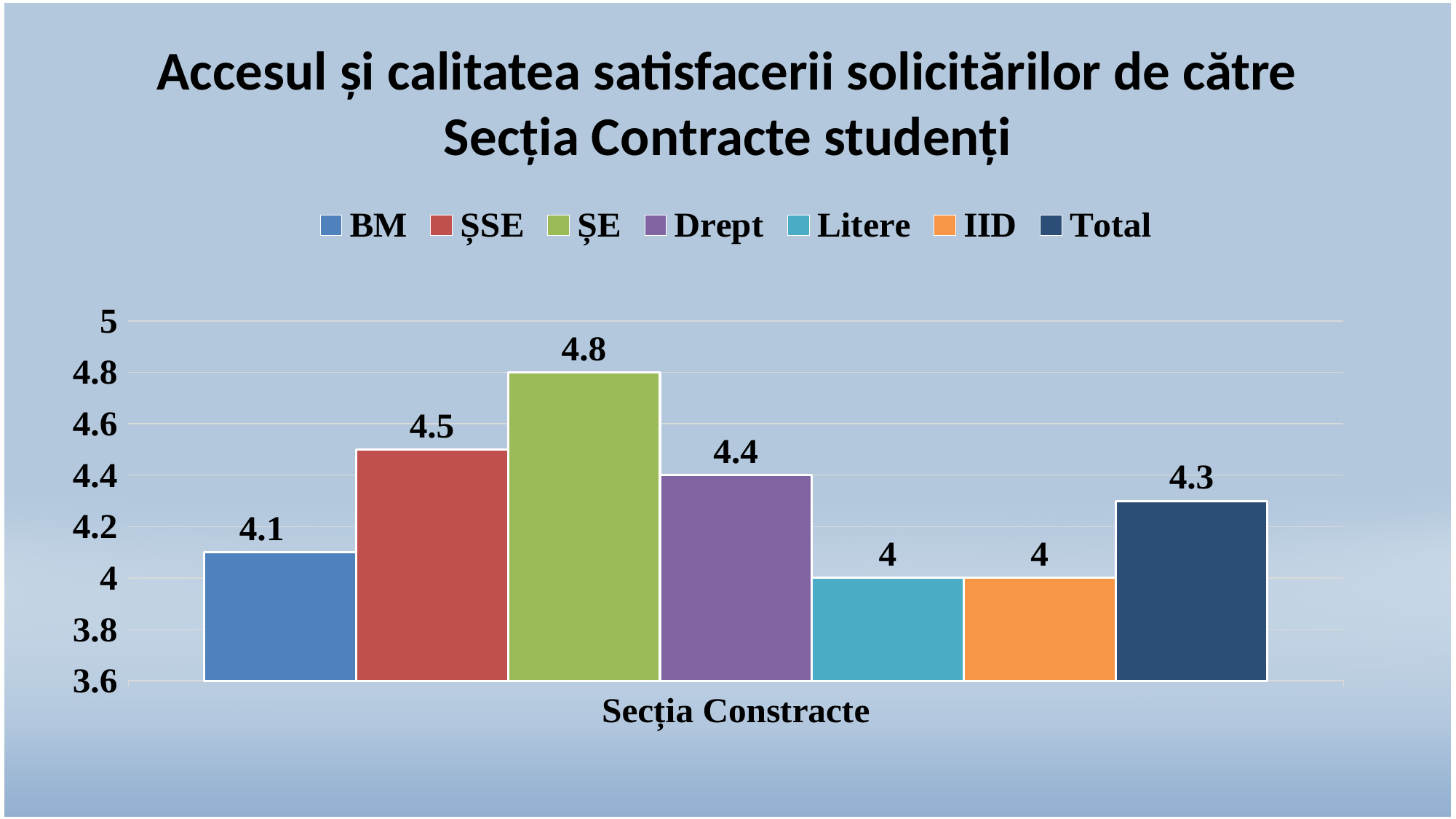
How many series does the legend list? 7 What is the value for BM? 4.1 Which series has the highest value? ȘE What is the difference between the values for ȘE and BM? 0.7 What is the value for Total? 4.3 What is the value for ȘE? 4.8 Which series share the lowest value? Litere and IID What is the label on the x axis? Secția Constracte What is the value for Drept? 4.4 What colour is the bar for Litere? Teal Which is larger, the value for ȘSE or the value for Drept? ȘSE What kind of chart is shown? Bar chart